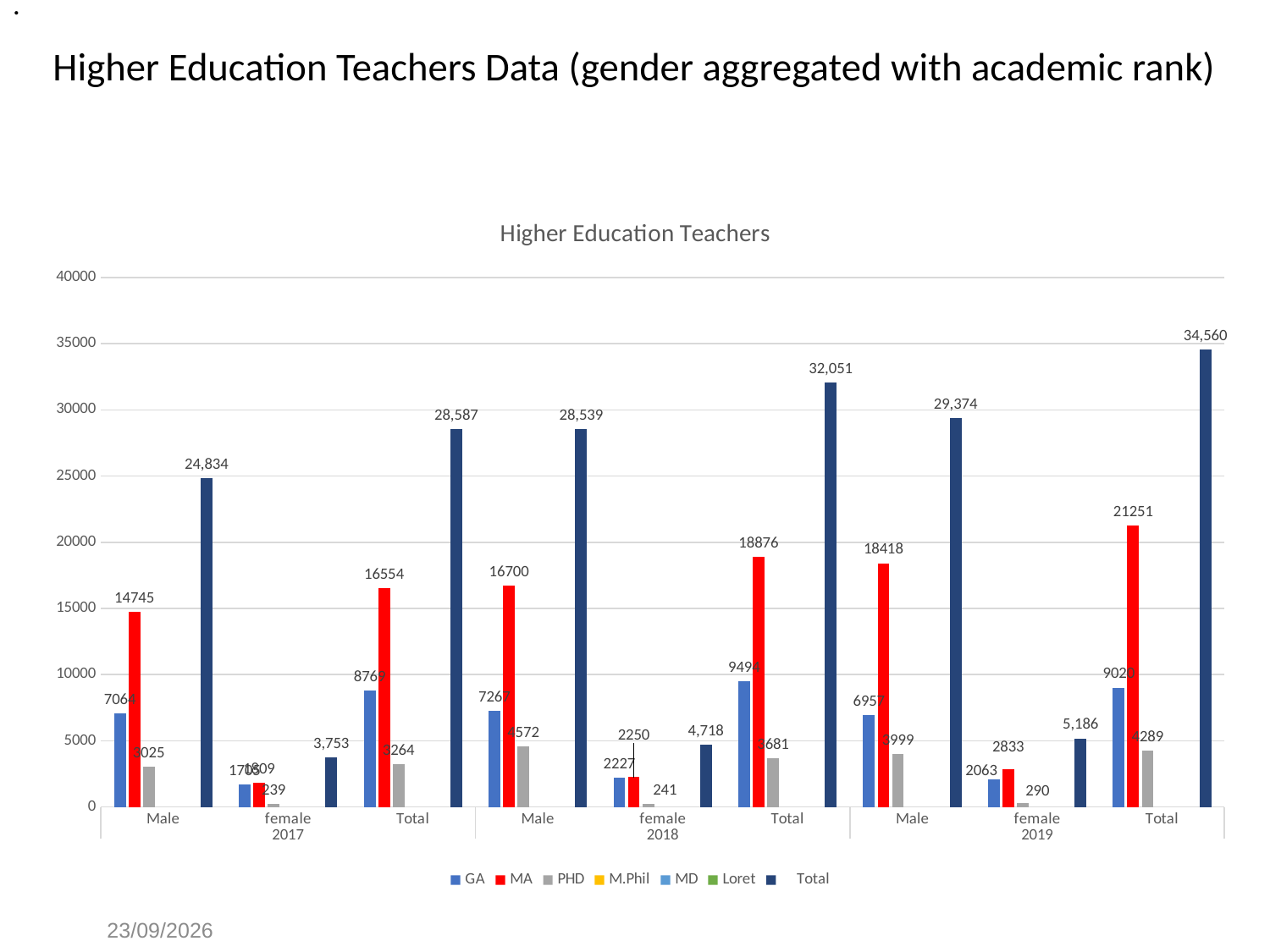
What is the PHD value for female in 2019? 290 What is the Total value for the Total category in 2019? 34,560 Is the MA value for Total 2019 greater or less than 20000? greater What kind of chart is shown on the slide? bar chart Which category has the lowest Total value? female 2017 What is the MA value for Male in 2019? 18418 Which category has the highest Total value? Total 2019 Do the Total values for the Total category rise or fall from 2017 to 2019? rise Which is larger, the MA value for Male 2018 or the MA value for Male 2019? Male 2019 How many series does the legend list? 7 How many categories are shown on the x axis? 9 What is the difference between the Total value for Total 2019 and the Total value for Total 2018? 2,509